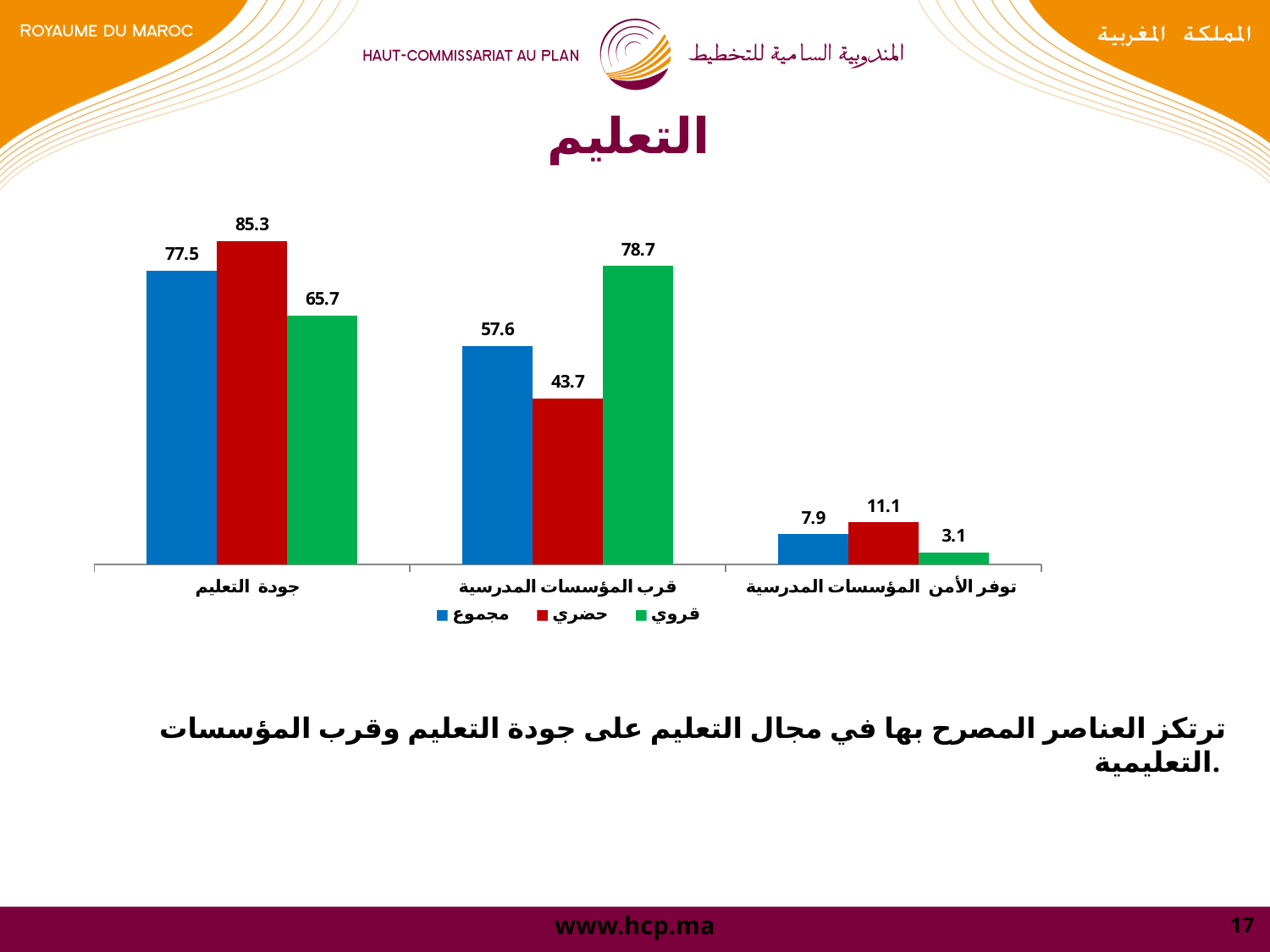
What is the value for قروي in the قرب المؤسسات المدرسية category? 78.7 What kind of chart is shown on the slide? bar chart In the قرب المؤسسات المدرسية category, which is larger: the مجموع value or the حضري value? مجموع What is the difference between the حضري and قروي values in the جودة التعليم category? 19.6 Which category has the highest value for the مجموع series? جودة التعليم Which category has the lowest value for the قروي series? توفر الأمن المؤسسات المدرسية Which colour represents the حضري series in the chart? red How many categories are shown on the x axis of the chart? 3 How many series does the legend list? 3 What is the value for حضري in the جودة التعليم category? 85.3 What is the title of the chart? التعليم What is the value for مجموع in the توفر الأمن المؤسسات المدرسية category? 7.9